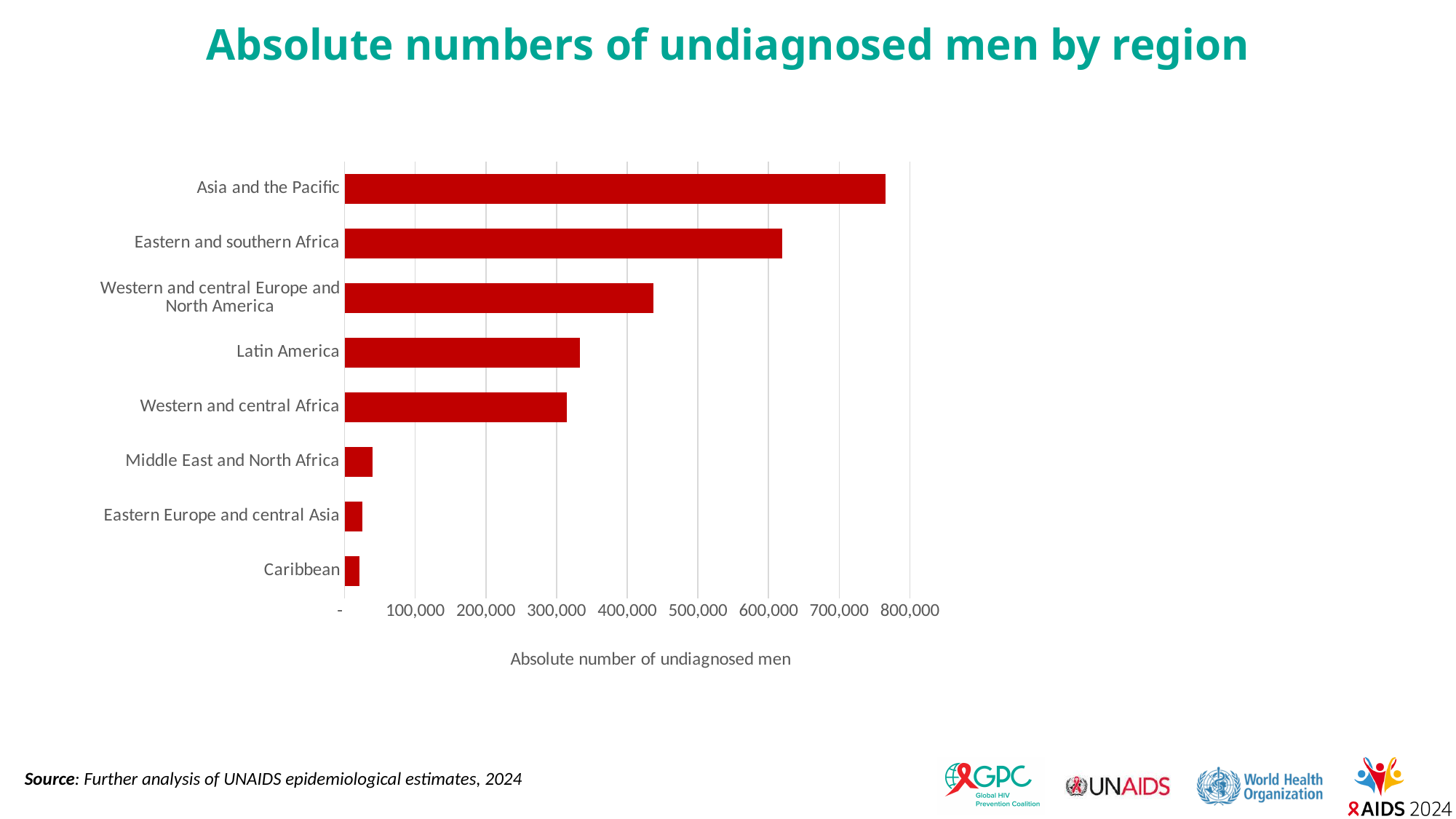
Is the value for Western and central Europe and North America greater or less than 400,000? greater Is the value for Eastern and southern Africa greater or less than 500,000? greater How many regions are shown in the chart? 8 Which has a larger value, Eastern and southern Africa or Western and central Africa? Eastern and southern Africa Is the value for Middle East and North Africa greater or less than 100,000? less What is the title of the chart? Absolute numbers of undiagnosed men by region Which has a larger value, Caribbean or Latin America? Latin America Which region has the highest absolute number of undiagnosed men? Asia and the Pacific What kind of chart is shown on the slide? Bar chart